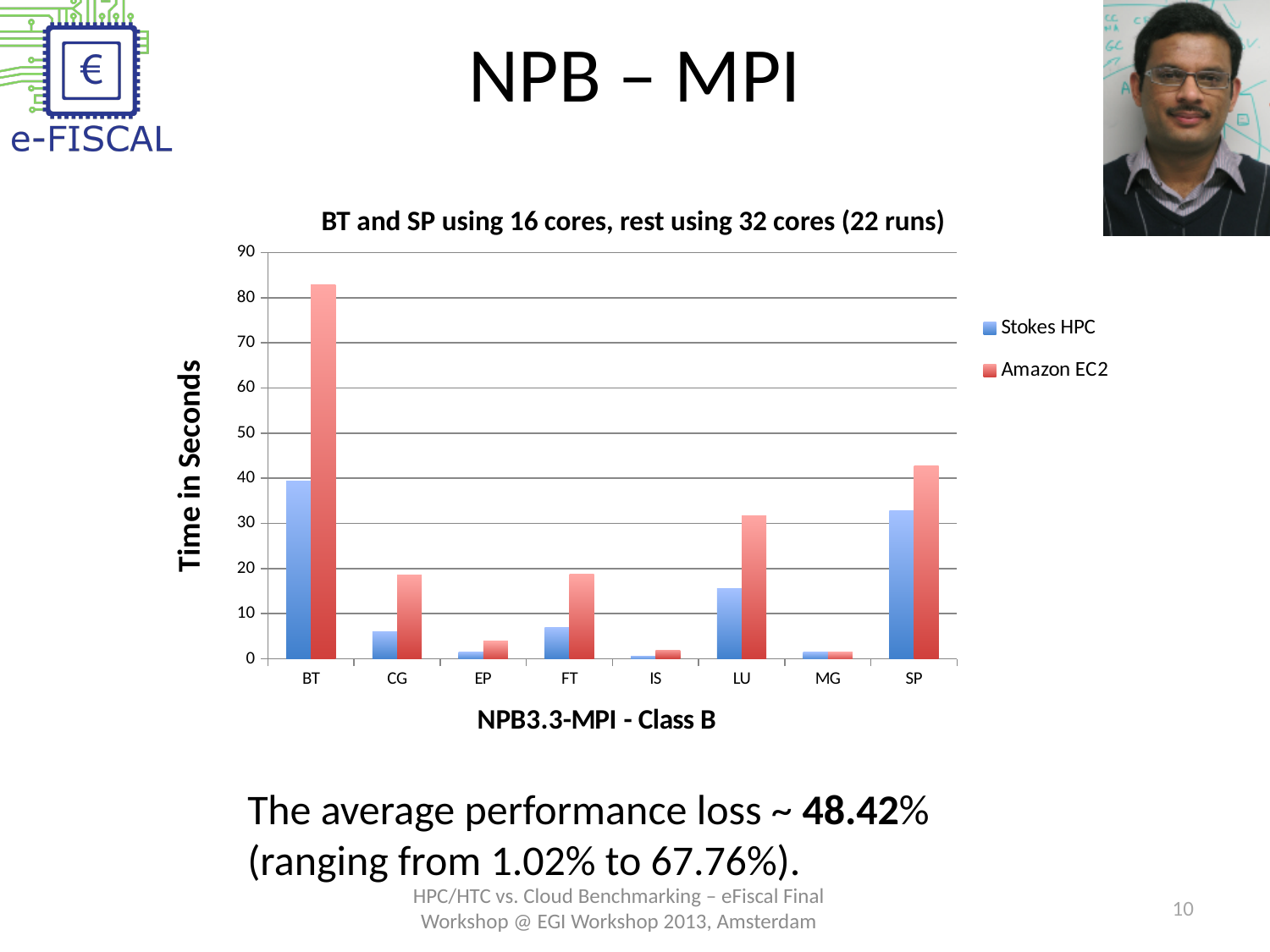
Which category has the highest Amazon EC2 time? BT How many series does the legend list? 2 Is the Amazon EC2 value for LU greater or less than 30? greater How many benchmark categories are shown on the x axis? 8 Which category has the highest Stokes HPC time? BT For LU, which is larger: the Stokes HPC time or the Amazon EC2 time? Amazon EC2 Is the Amazon EC2 value for BT greater or less than 80? greater What kind of chart is shown on the slide? bar chart Which category has the lowest Stokes HPC time? IS Is the Amazon EC2 value for SP greater or less than 40? greater What is the title of the chart? BT and SP using 16 cores, rest using 32 cores (22 runs)